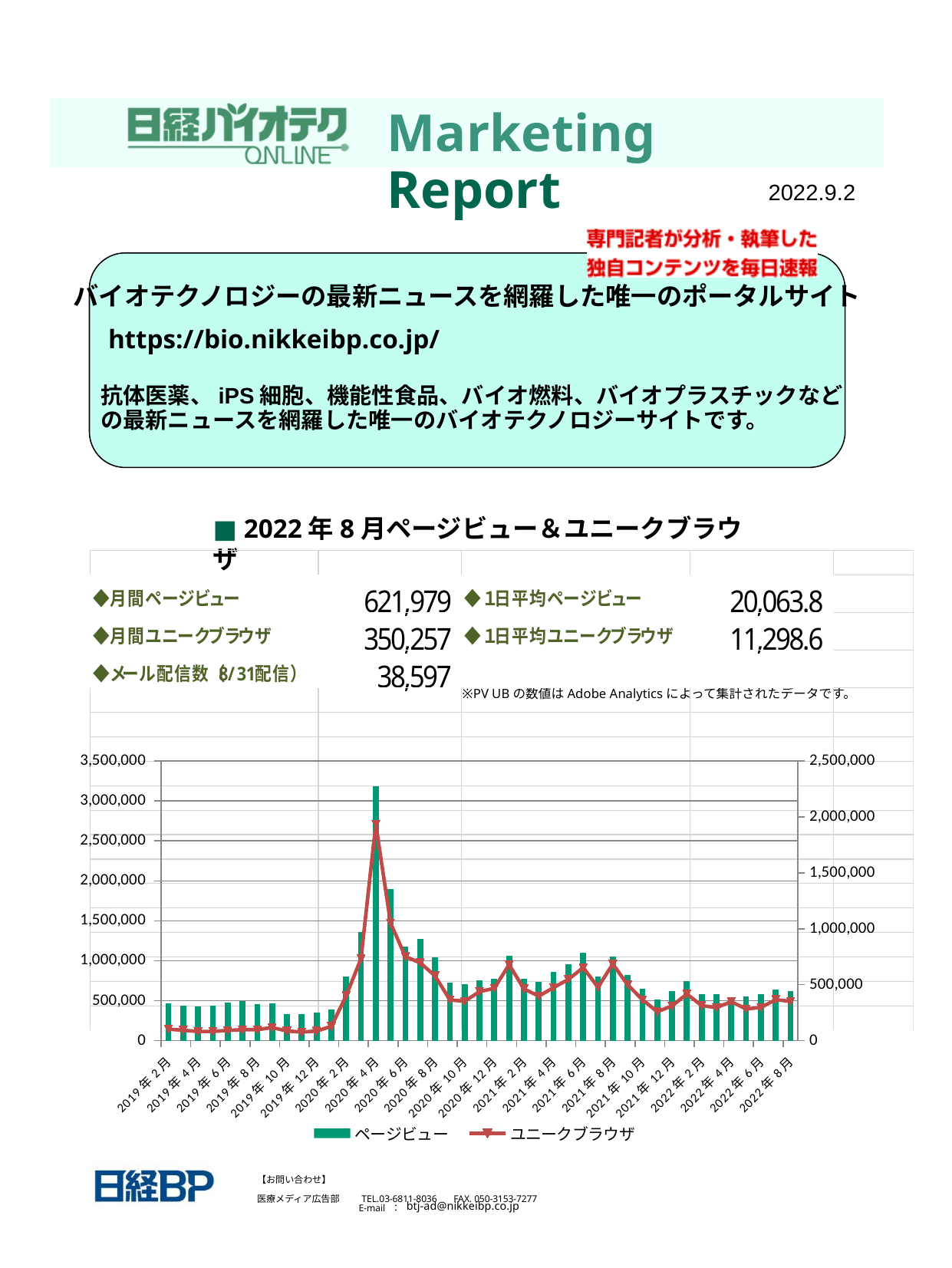
Which series is drawn as bars in the chart? ページビュー What is the maximum value shown on the left vertical axis of the chart? 3,500,000 What kind of chart is shown on the slide? A combined bar and line chart Is the page view value for 2019年12月 greater or less than 500,000? less In which month do the page views (ページビュー) reach their highest value? 2020年4月 What monthly page view figure (月間ページビュー) is printed for August 2022? 621,979 Is the peak unique browser (ユニークブラウザ) value in 2020年4月 greater or less than 1,500,000 on the right axis? greater Do page views rise or fall from 2020年4月 to 2020年10月? fall Is the peak page view value in 2020年4月 greater or less than 3,000,000? greater Which month has higher page views, 2020年4月 or 2021年2月? 2020年4月 How many series does the chart legend list? 2 Which series is drawn as a line with markers in the chart? ユニークブラウザ